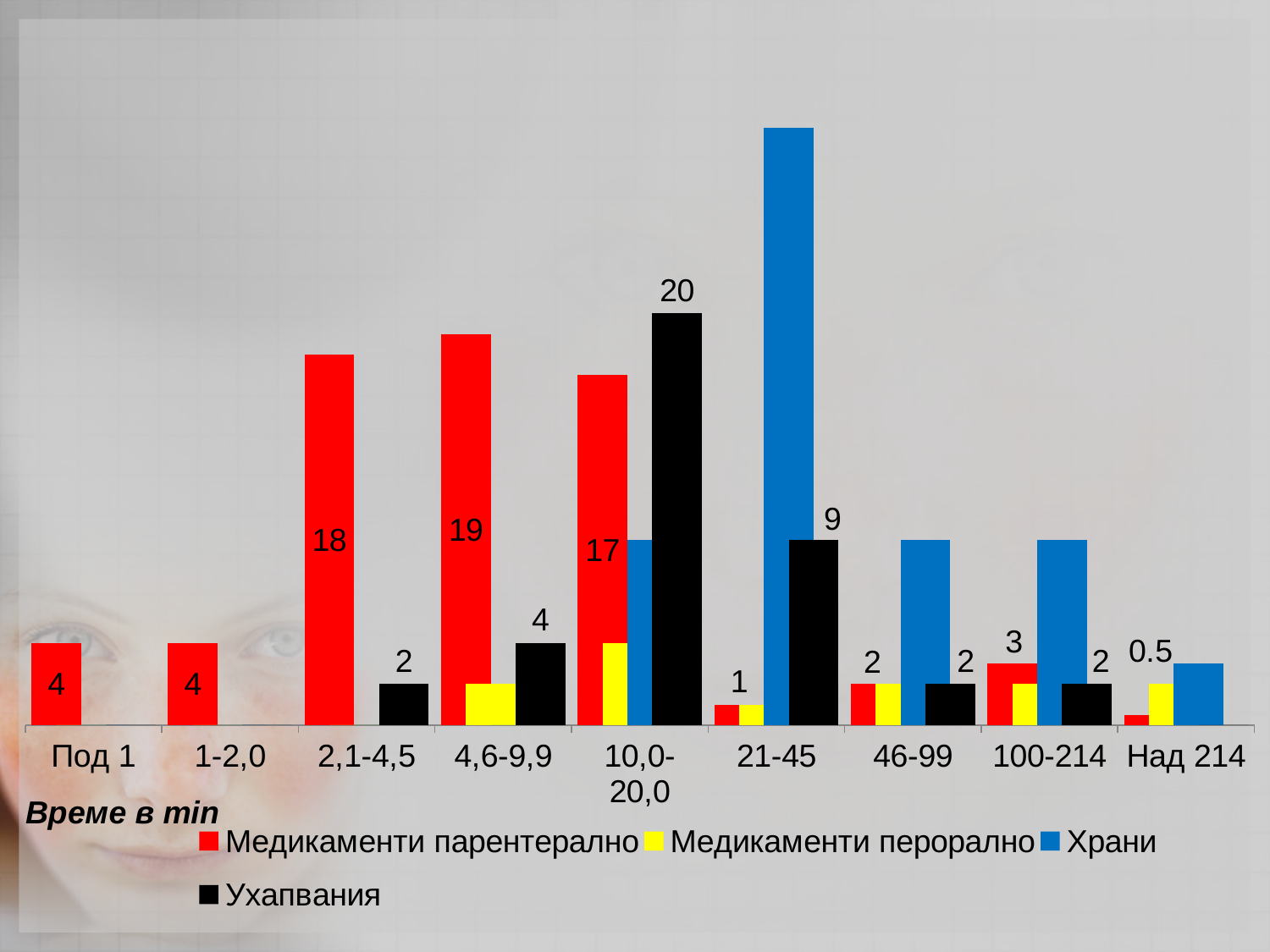
What is the difference between the Ухапвания values for 10,0-20,0 and 21-45? 11 What is the difference between the Медикаменти парентерално values for 4,6-9,9 and 2,1-4,5? 1 How many series does the legend list? 4 What is the value for Медикаменти парентерално in the Над 214 category? 0.5 What kind of chart is shown on the slide? Bar chart In the 10,0-20,0 category, which is larger: Медикаменти парентерално or Ухапвания? Ухапвания In which category is the Медикаменти парентерално series lowest? Над 214 What is the value for Ухапвания in the 21-45 category? 9 In which category is the Медикаменти парентерално series highest? 4,6-9,9 What is the value for Медикаменти парентерално in the 2,1-4,5 category? 18 What is the value for Ухапвания in the 10,0-20,0 category? 20 How many categories are shown on the x axis? 9